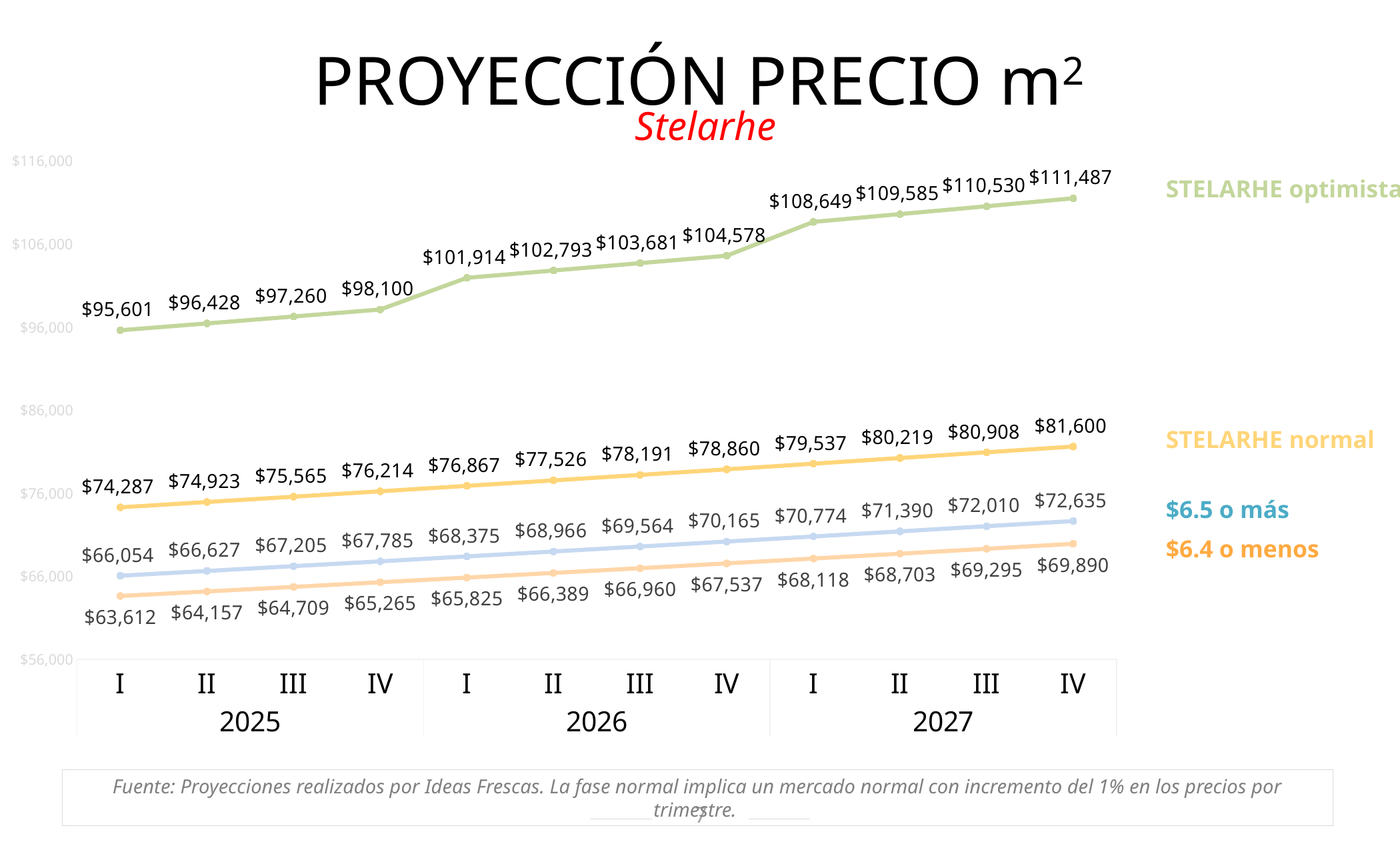
Do the values of the STELARHE normal series rise or fall from 2025 to 2027? Rise What is the value of the $6.4 o menos series in quarter I of 2025? $63,612 How many series does the chart show? 4 How many quarterly points are plotted along the x axis? 12 What is the value of STELARHE normal in quarter I of 2025? $74,287 Which series has the highest value in quarter IV of 2027? STELARHE optimista Which series has the lowest value in quarter I of 2025? $6.4 o menos What is the title of the chart? PROYECCIÓN PRECIO m² Stelarhe What type of chart is shown on the slide? Line chart What is the difference between the STELARHE optimista values in quarter IV of 2027 and quarter I of 2025? $15,886 What is the value of STELARHE optimista in quarter IV of 2027? $111,487 What is the value of the $6.5 o más series in quarter IV of 2026? $70,165